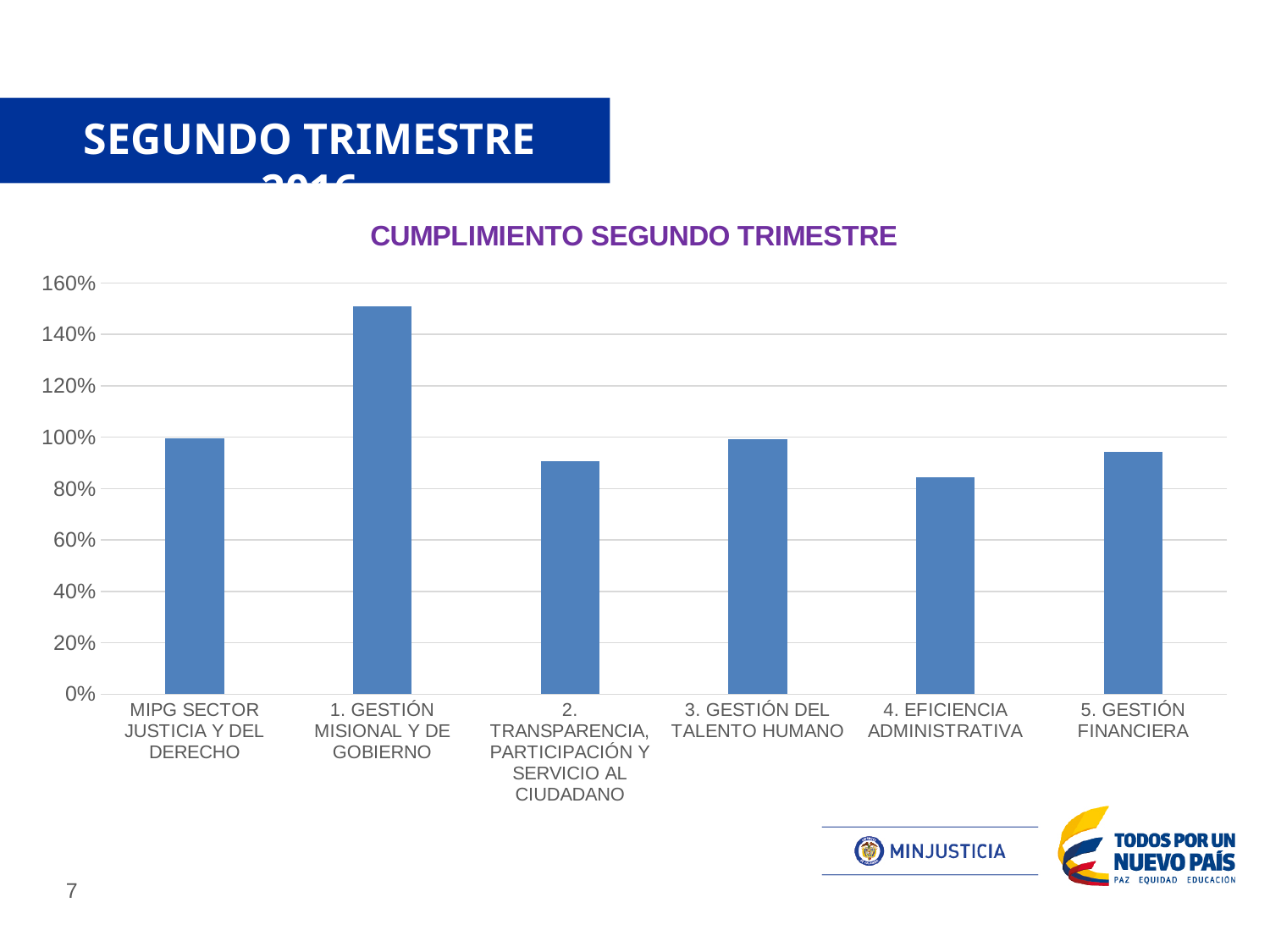
Which category has the lowest value in the chart? 4. EFICIENCIA ADMINISTRATIVA What colour are the bars in the chart? Blue Is the value for 2. TRANSPARENCIA, PARTICIPACIÓN Y SERVICIO AL CIUDADANO greater or less than 100%? less Which category has the highest value in the chart? 1. GESTIÓN MISIONAL Y DE GOBIERNO What is the title of the chart? CUMPLIMIENTO SEGUNDO TRIMESTRE Which is larger: the value for 1. GESTIÓN MISIONAL Y DE GOBIERNO or the value for 2. TRANSPARENCIA, PARTICIPACIÓN Y SERVICIO AL CIUDADANO? 1. GESTIÓN MISIONAL Y DE GOBIERNO How many categories are plotted on the x axis of the chart? 6 Is the value for 4. EFICIENCIA ADMINISTRATIVA greater or less than 80%? greater What type of chart is shown on the slide? Bar chart Is the value for 5. GESTIÓN FINANCIERA greater or less than 100%? less Which is larger: the value for 3. GESTIÓN DEL TALENTO HUMANO or the value for 4. EFICIENCIA ADMINISTRATIVA? 3. GESTIÓN DEL TALENTO HUMANO